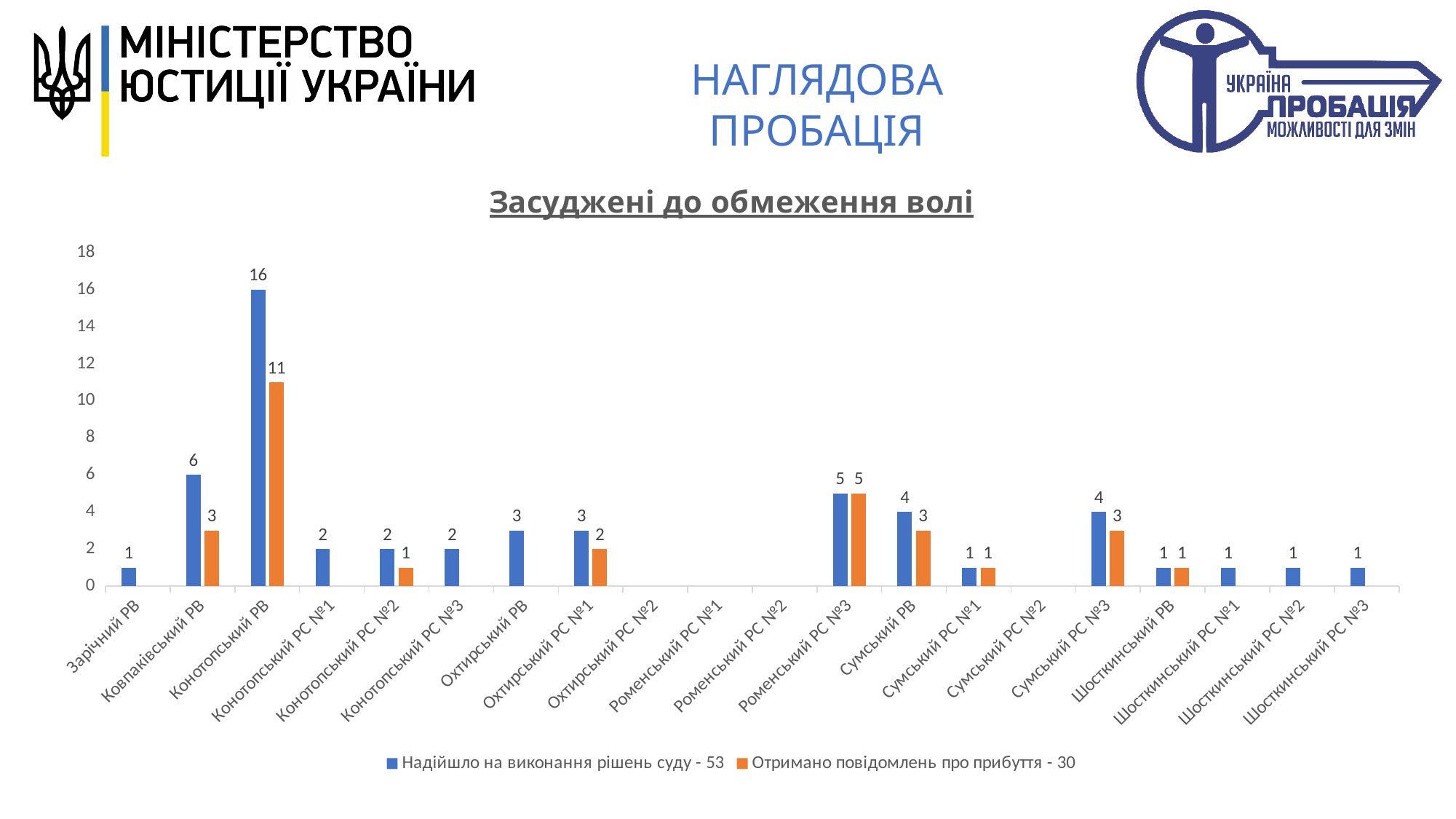
What is the value of 'Надійшло на виконання рішень суду' for Конотопський РВ? 16 Is the value of 'Надійшло на виконання рішень суду' for Конотопський РВ greater or less than 10? greater Which is larger for Сумський РВ: 'Надійшло на виконання рішень суду' or 'Отримано повідомлень про прибуття'? Надійшло на виконання рішень суду What is the value of 'Надійшло на виконання рішень суду' for Охтирський РВ? 3 What is the value of 'Отримано повідомлень про прибуття' for Конотопський РВ? 11 What is the value of 'Отримано повідомлень про прибуття' for Роменський РС №3? 5 How many series does the legend list? 2 How many categories are shown on the x axis? 20 What is the difference between 'Надійшло на виконання рішень суду' and 'Отримано повідомлень про прибуття' for Ковпаківський РВ? 3 What is the title of the chart? Засуджені до обмеження волі Which category has the highest value for 'Надійшло на виконання рішень суду'? Конотопський РВ What type of chart is shown on the slide? bar chart